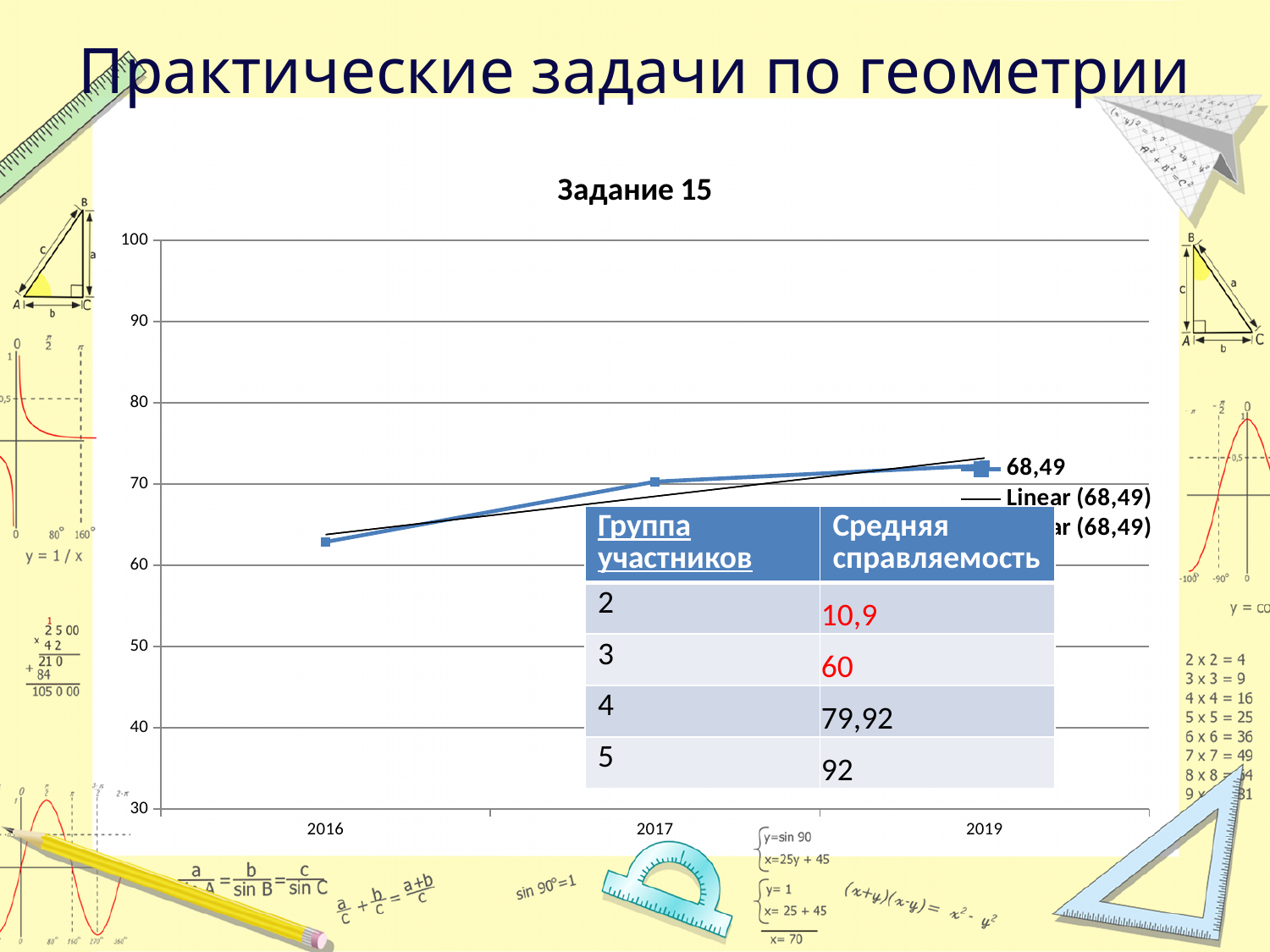
Is the value for 2016 greater or less than 60? greater What is the title of the chart? Задание 15 Which year has the highest value in the chart? 2019 What type of chart is shown on the slide? line chart Which is larger, the value for 2016 or the value for 2019? 2019 Is the value for 2019 greater or less than 80? less Which year has the lowest value in the chart? 2016 How many data points are plotted on the line in the chart? 3 Which years are shown on the x axis of the chart? 2016, 2017, 2019 Is the value for 2016 greater or less than 70? less Do the values rise or fall from 2016 to 2019? rise